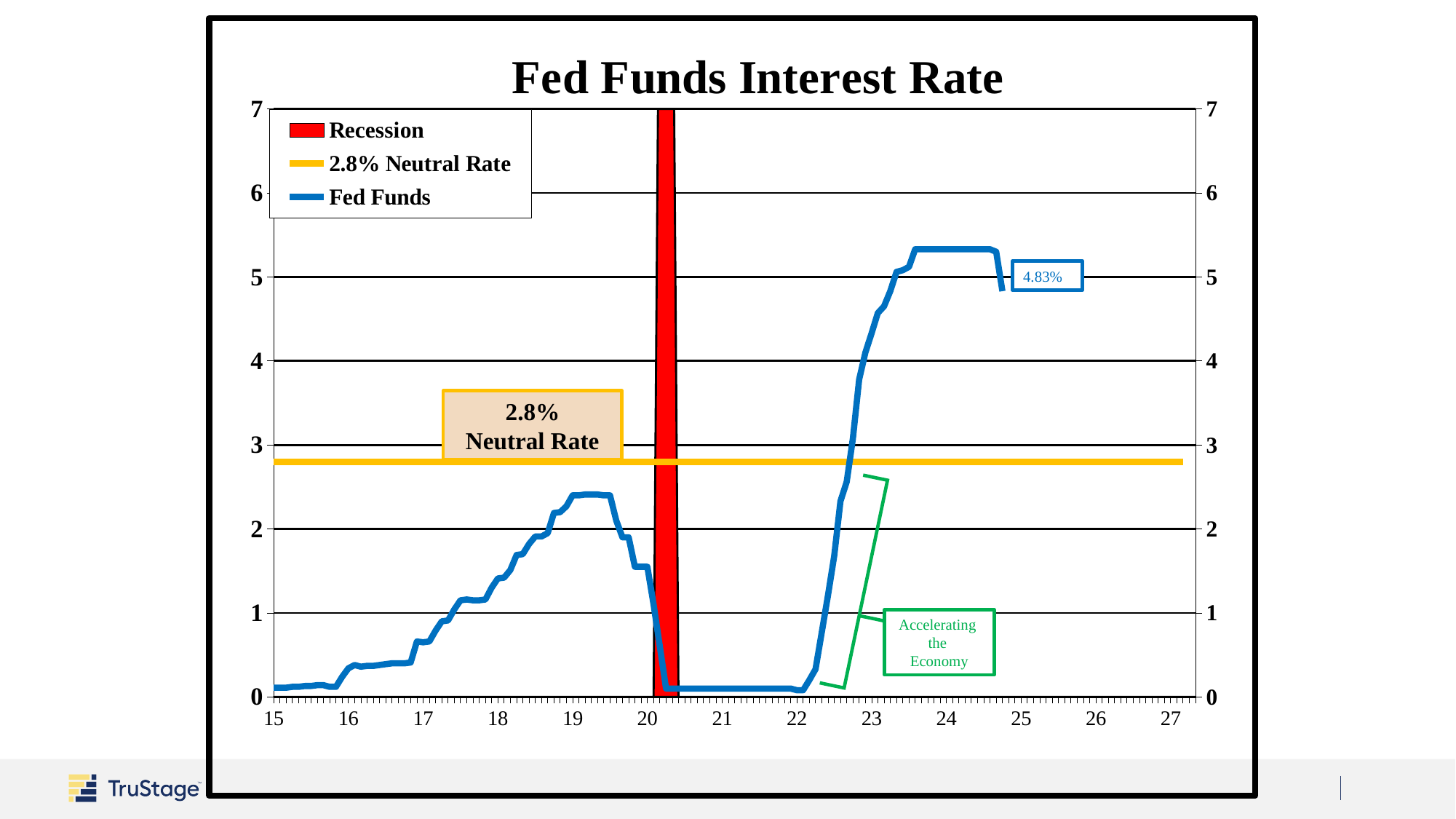
What is the value of the Neutral Rate line? 2.8% How many series does the legend list? 3 Is the Fed Funds value in 2021 greater or less than 1? less What is the value shown in the data label at the end of the Fed Funds line? 4.83% What kind of chart is shown on the slide? line chart What colour is used for the Recession series in the legend? red Does the Fed Funds line rise or fall between mid-2019 and 2020? fall Does the Fed Funds line rise or fall between 2022 and 2023? rise Is the Fed Funds peak in 2019 greater or less than 3? less Is the Fed Funds value in 2024 greater or less than 5? greater In 2024, which is higher: the Fed Funds rate or the 2.8% Neutral Rate? Fed Funds What is the title of the chart? Fed Funds Interest Rate